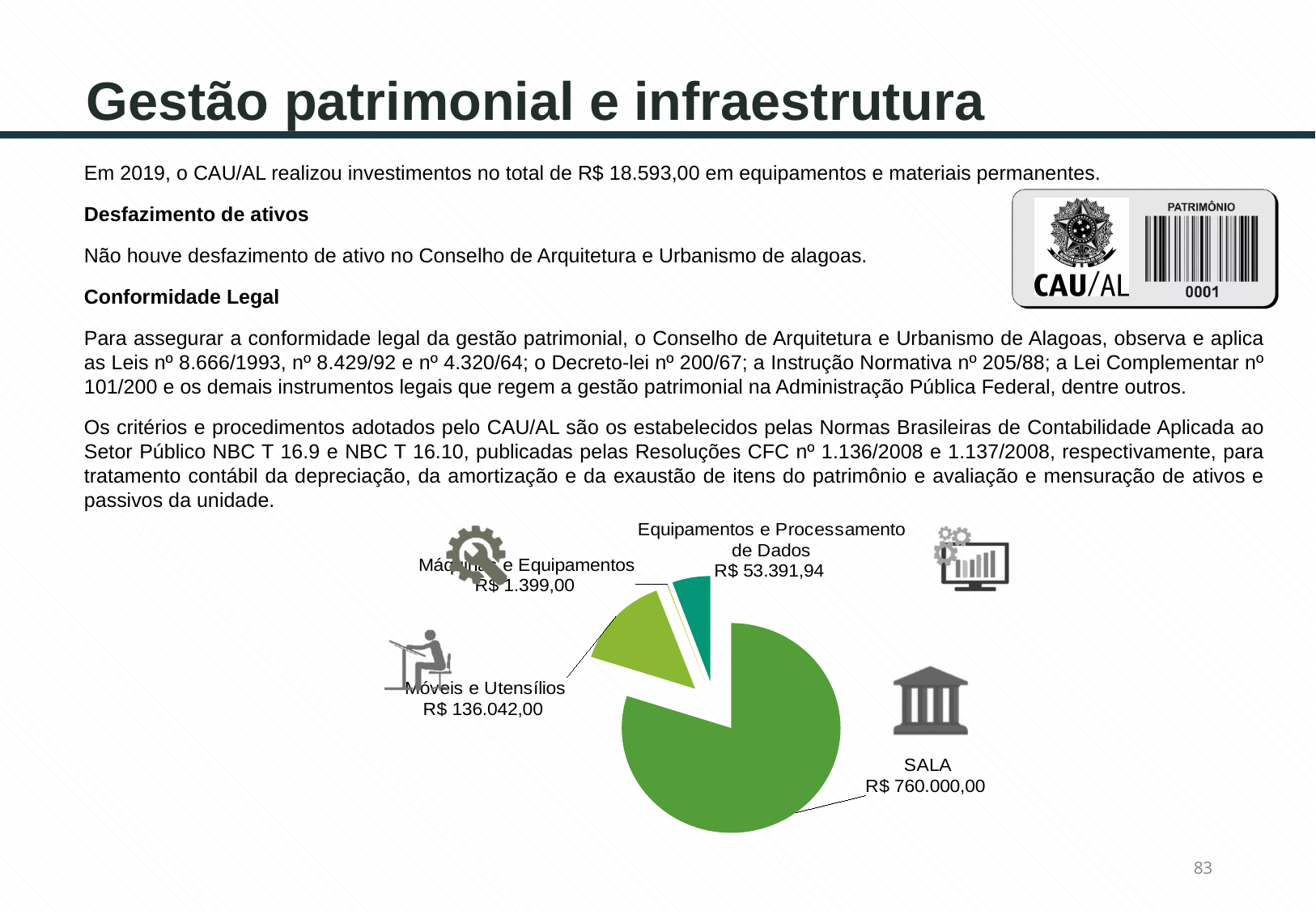
What is the value shown for Equipamentos e Processamento de Dados in the pie chart? R$ 53.391,94 How many slices does the pie chart have? 4 What is the value shown for Máquinas e Equipamentos in the pie chart? R$ 1.399,00 What colour is the SALA slice in the pie chart? Green What is the difference between the SALA value and the Móveis e Utensílios value in the pie chart? R$ 623.958,00 What is the value shown for SALA in the pie chart? R$ 760.000,00 Which category has the smallest slice in the pie chart? Máquinas e Equipamentos What is the difference between the Móveis e Utensílios value and the Equipamentos e Processamento de Dados value in the pie chart? R$ 82.650,06 Which is larger in the pie chart: Móveis e Utensílios or Equipamentos e Processamento de Dados? Móveis e Utensílios What is the value shown for Móveis e Utensílios in the pie chart? R$ 136.042,00 What kind of chart is shown on the slide? Pie chart Which category has the largest slice in the pie chart? SALA